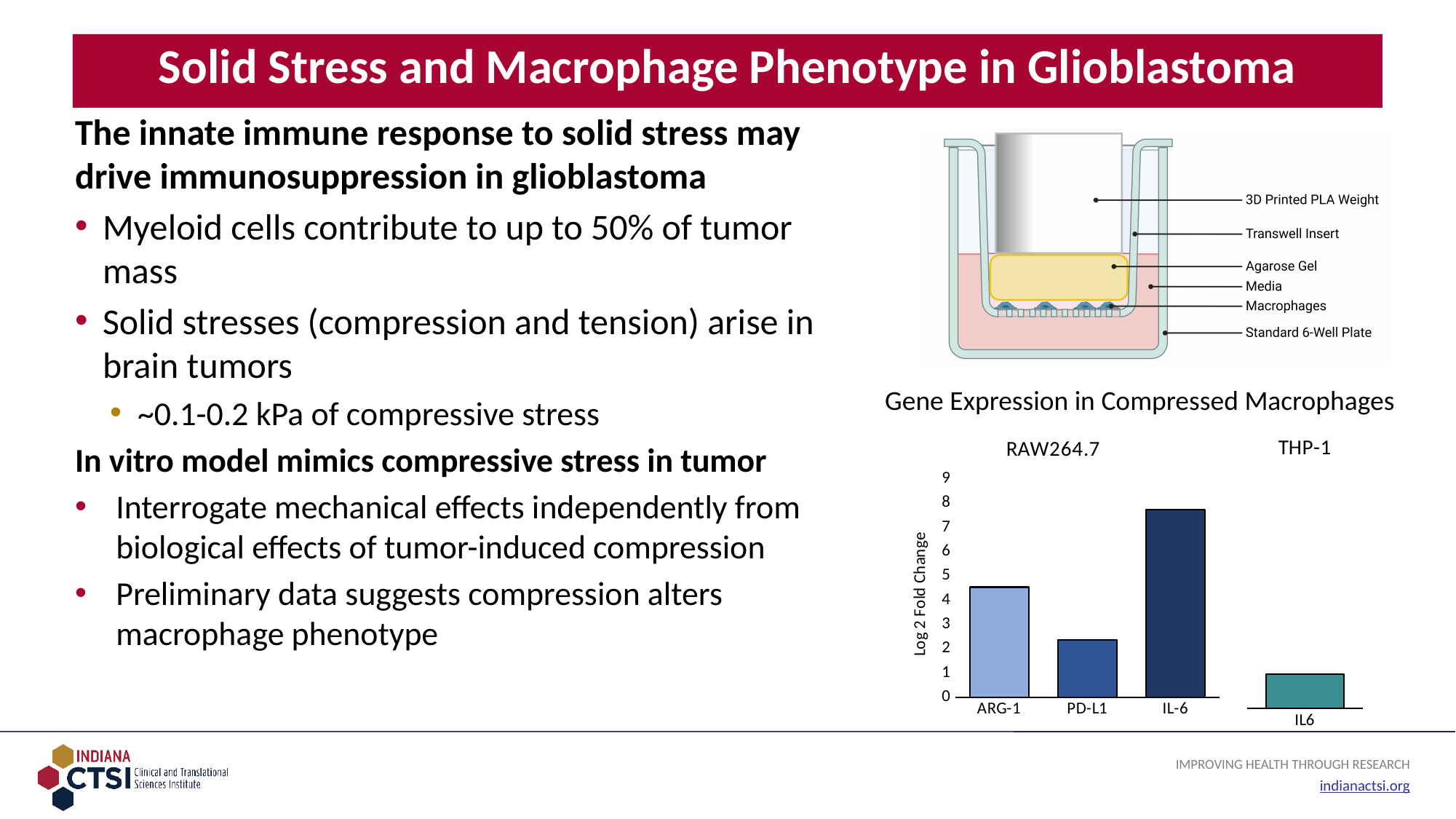
What is the y-axis label of the "Gene Expression in Compressed Macrophages" chart? Log 2 Fold Change In the "Gene Expression in Compressed Macrophages" chart, which bar is the lowest? IL6 (THP-1) How many bars are plotted in the "Gene Expression in Compressed Macrophages" chart? 4 In the "Gene Expression in Compressed Macrophages" chart, which is larger, the IL-6 value for RAW264.7 or the IL6 value for THP-1? IL-6 for RAW264.7 In the "Gene Expression in Compressed Macrophages" chart, is the value for PD-L1 greater or less than 3? less In the "Gene Expression in Compressed Macrophages" chart, is the value for IL-6 (RAW264.7) greater or less than 7? greater In the "Gene Expression in Compressed Macrophages" chart, is the value for ARG-1 greater or less than 4? greater In the "Gene Expression in Compressed Macrophages" chart, which gene has the highest Log 2 Fold Change? IL-6 In the "Gene Expression in Compressed Macrophages" chart, among the RAW264.7 genes, which has the lowest Log 2 Fold Change? PD-L1 In the "Gene Expression in Compressed Macrophages" chart, which is larger, the value for ARG-1 or the value for PD-L1? ARG-1 What kind of chart is shown under the title "Gene Expression in Compressed Macrophages"? bar chart